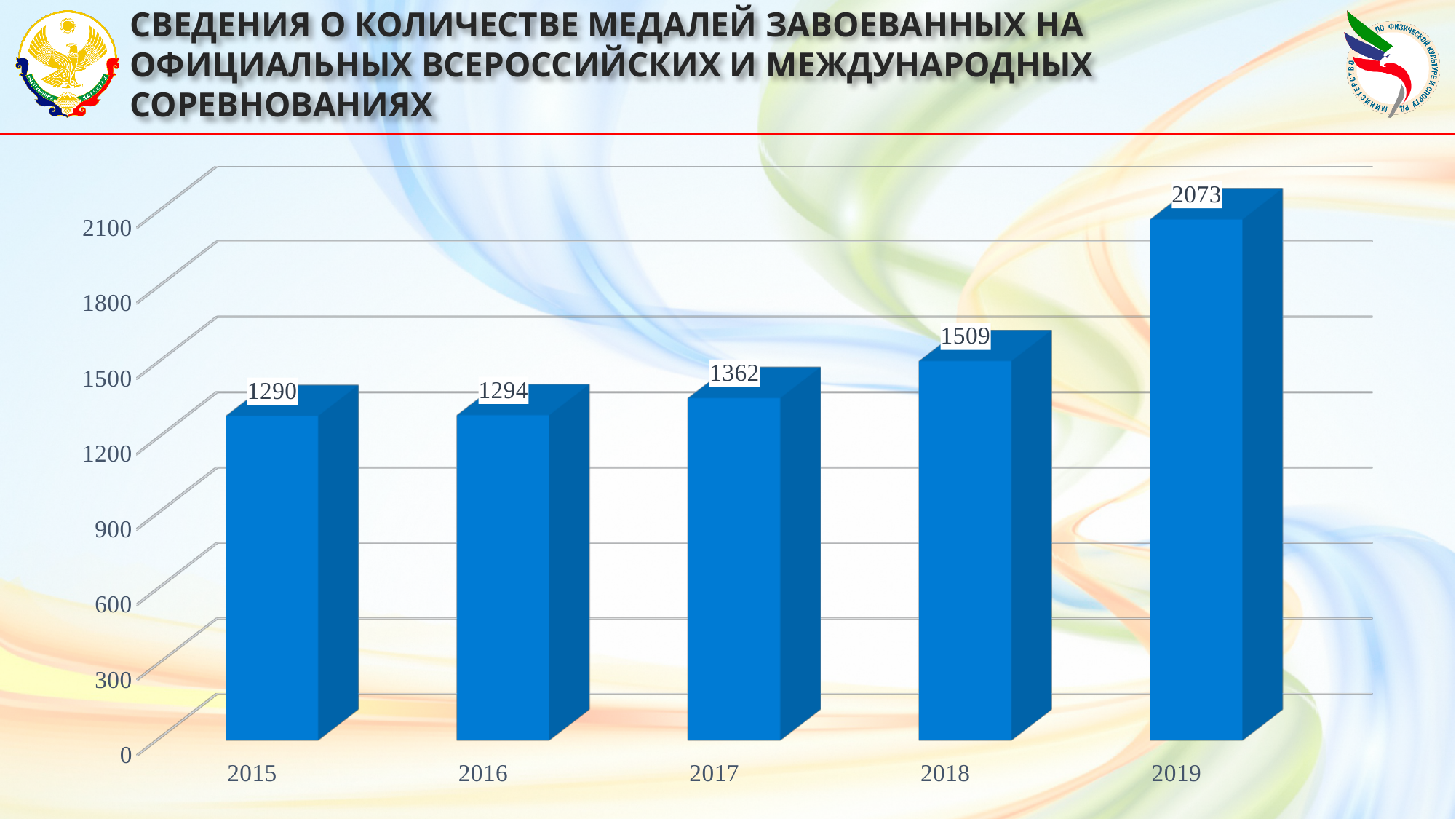
What is the value shown for 2017? 1362 What is the value shown for 2015? 1290 What kind of chart is shown on the slide? bar chart Is the value for 2018 greater or less than 1500? greater What is the difference between the values for 2017 and 2016? 68 What is the difference between the values for 2019 and 2018? 564 How many medals were won in 2019? 2073 Which year has the lowest number of medals? 2015 Which is larger, the value for 2018 or the value for 2017? 2018 How many years are shown on the x axis? 5 Which year has the highest number of medals? 2019 Do the values rise or fall from 2015 to 2019? rise